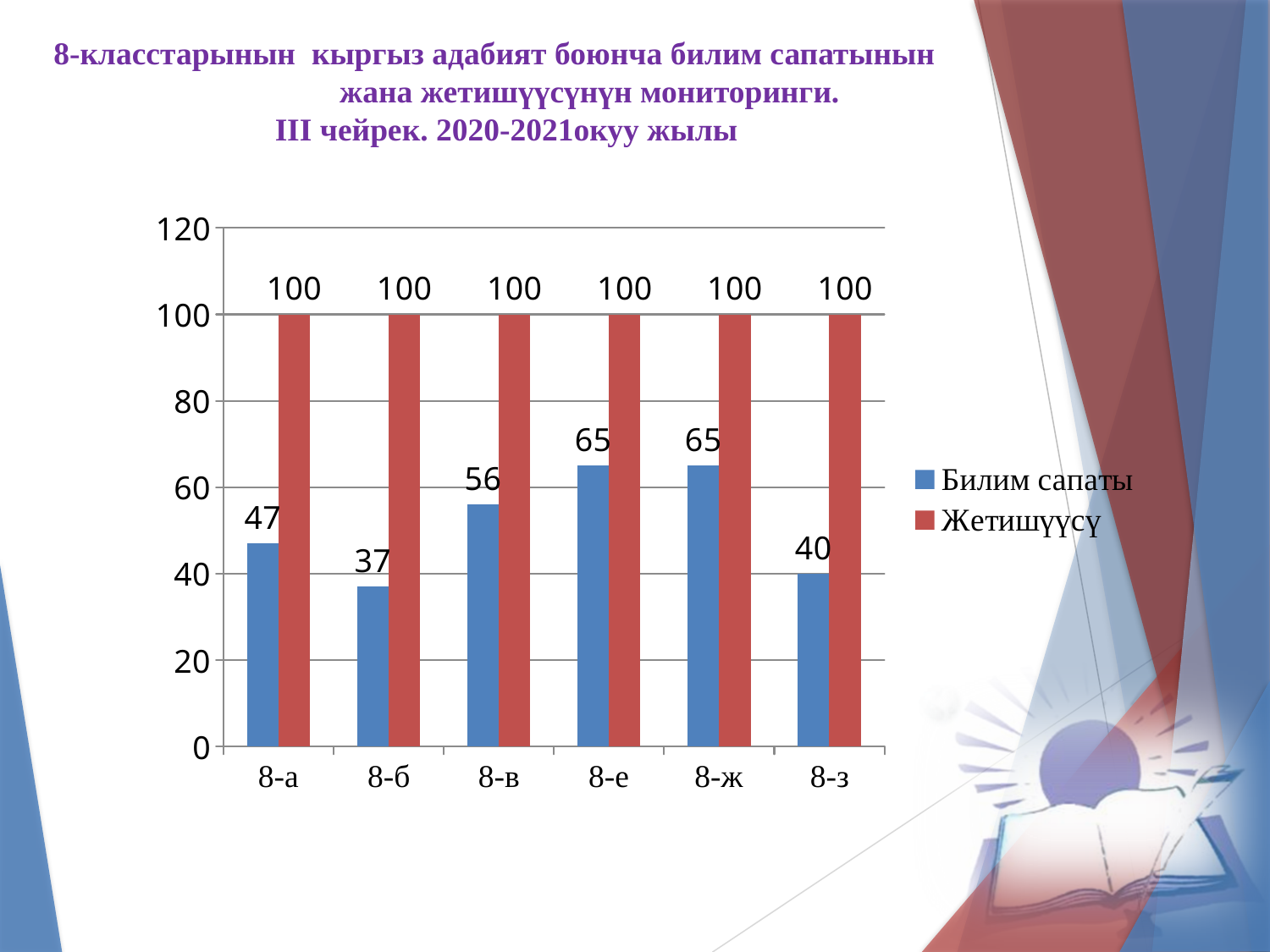
What kind of chart is shown on the slide? bar chart What is the value of Билим сапаты for 8-з? 40 What is the value of Жетишүүсү for 8-б? 100 Is the Билим сапаты value for 8-а greater or less than 60? less How many classes are shown on the x axis? 6 What is the difference between Жетишүүсү and Билим сапаты for 8-б? 63 What is the difference between the Билим сапаты values for 8-е and 8-а? 18 Which colour represents Жетишүүсү in the legend? red Which is larger, the Билим сапаты value for 8-в or for 8-з? 8-в How many series does the legend list? 2 Which class has the lowest Билим сапаты value? 8-б What is the value of Билим сапаты for 8-в? 56